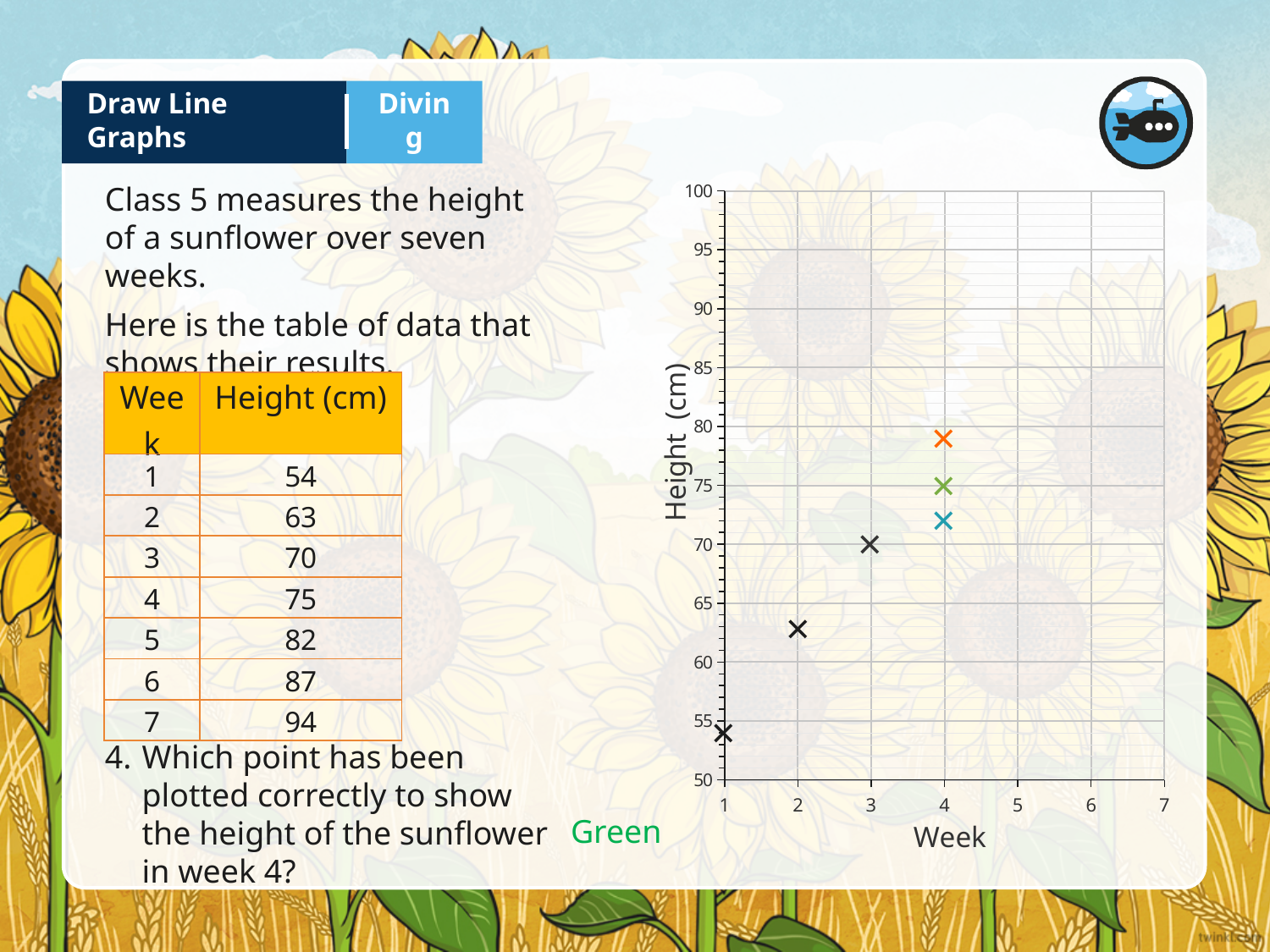
How many points (crosses) are plotted on the chart? 6 Do the black points rise or fall from week 1 to week 3? rise What is the title of the horizontal axis of the chart? Week Which of the three crosses at week 4 is plotted lowest on the chart? the blue cross What is the title of the vertical axis of the chart? Height (cm) Is the value of the blue cross at week 4 greater or less than 75? less What is the height value of the black point plotted at week 3? 70 Which is plotted higher on the chart: the point at week 2 or the point at week 3? the point at week 3 Is the value of the point plotted at week 2 greater or less than 60? greater Which of the three crosses at week 4 is plotted highest on the chart? the orange cross What height does the green cross at week 4 show? 75 Is the value of the orange cross at week 4 greater or less than 75? greater